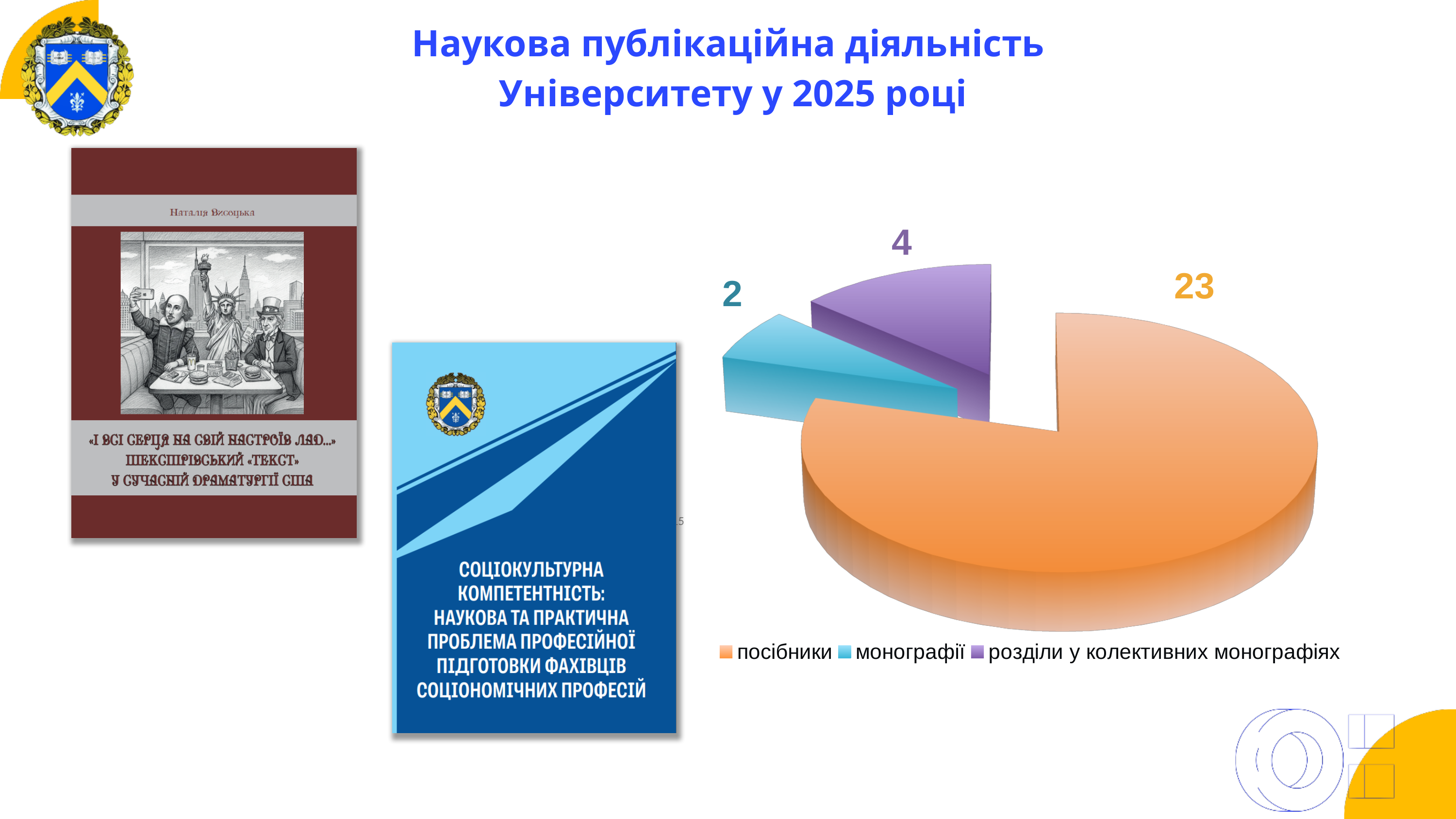
What value is shown for посібники in the pie chart? 23 What kind of chart is shown on the slide? pie chart What is the total of all the values shown in the pie chart? 29 What value is shown for монографії in the pie chart? 2 What is the difference between the values for посібники and розділи у колективних монографіях? 19 Which category has the smallest slice in the pie chart? монографії How many entries does the chart legend list? 3 How many slices does the pie chart have? 3 What colour is the slice for посібники in the pie chart? orange What value is shown for розділи у колективних монографіях in the pie chart? 4 Which category has the largest slice in the pie chart? посібники Which is larger: the value for монографії or the value for розділи у колективних монографіях? розділи у колективних монографіях